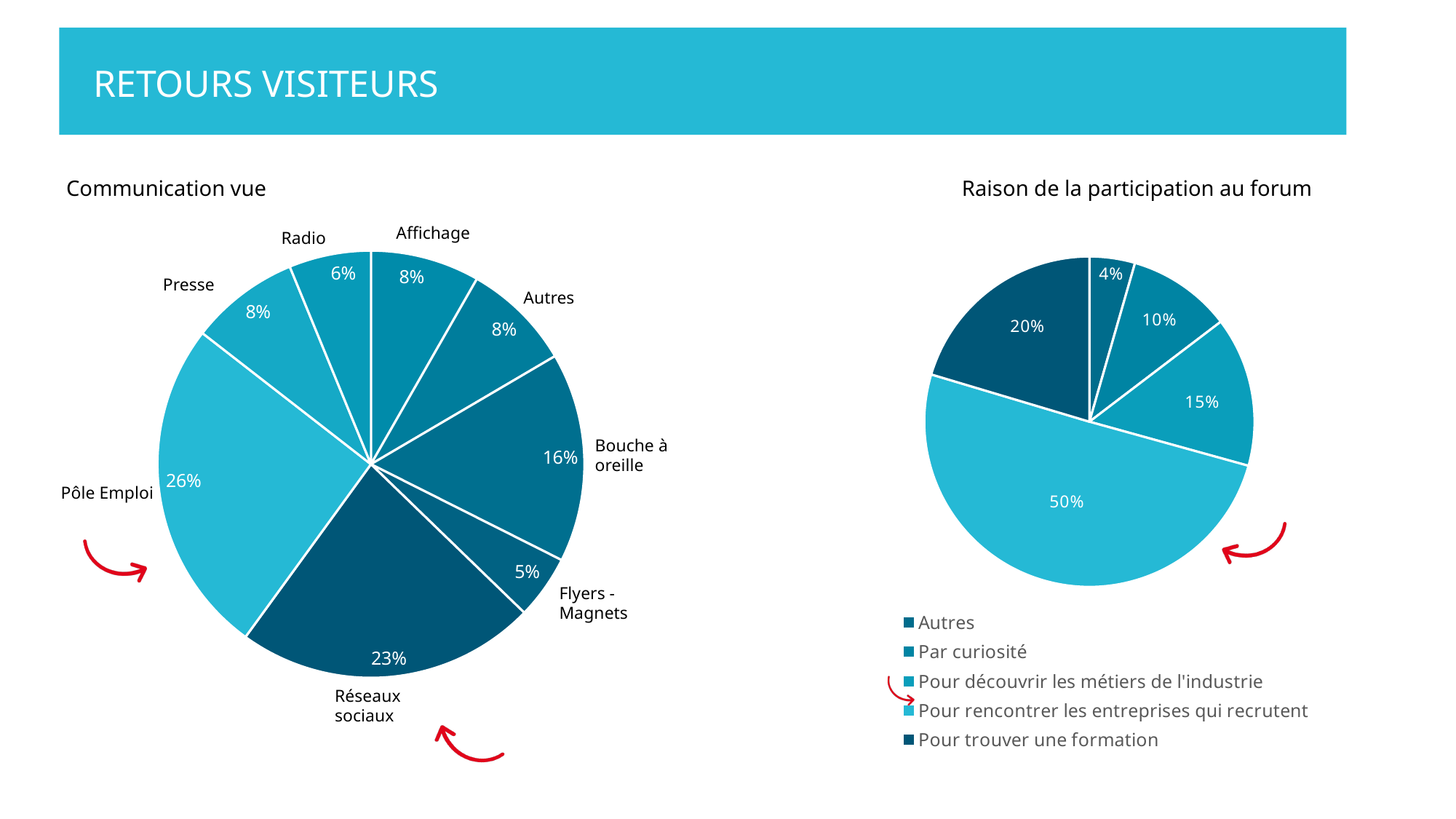
How many entries does the legend of the 'Raison de la participation au forum' chart list? 5 In the 'Communication vue' pie chart, what percentage is shown for Pôle Emploi? 26% In the 'Communication vue' pie chart, which is larger: Presse or Bouche à oreille? Bouche à oreille How many slices does the 'Communication vue' pie chart have? 8 In the 'Communication vue' pie chart, which category has the largest share? Pôle Emploi In the 'Communication vue' pie chart, what percentage is shown for Bouche à oreille? 16% What type of chart is 'Raison de la participation au forum'? Pie chart In the 'Communication vue' pie chart, what is the difference in percentage points between Réseaux sociaux and Radio? 17 In the 'Communication vue' pie chart, which category has the smallest share? Flyers - Magnets In the 'Raison de la participation au forum' pie chart, what percentage is shown for 'Pour trouver une formation'? 20% In the 'Raison de la participation au forum' pie chart, which category has the smallest share? Autres In the 'Raison de la participation au forum' pie chart, what percentage is shown for 'Pour rencontrer les entreprises qui recrutent'? 50%